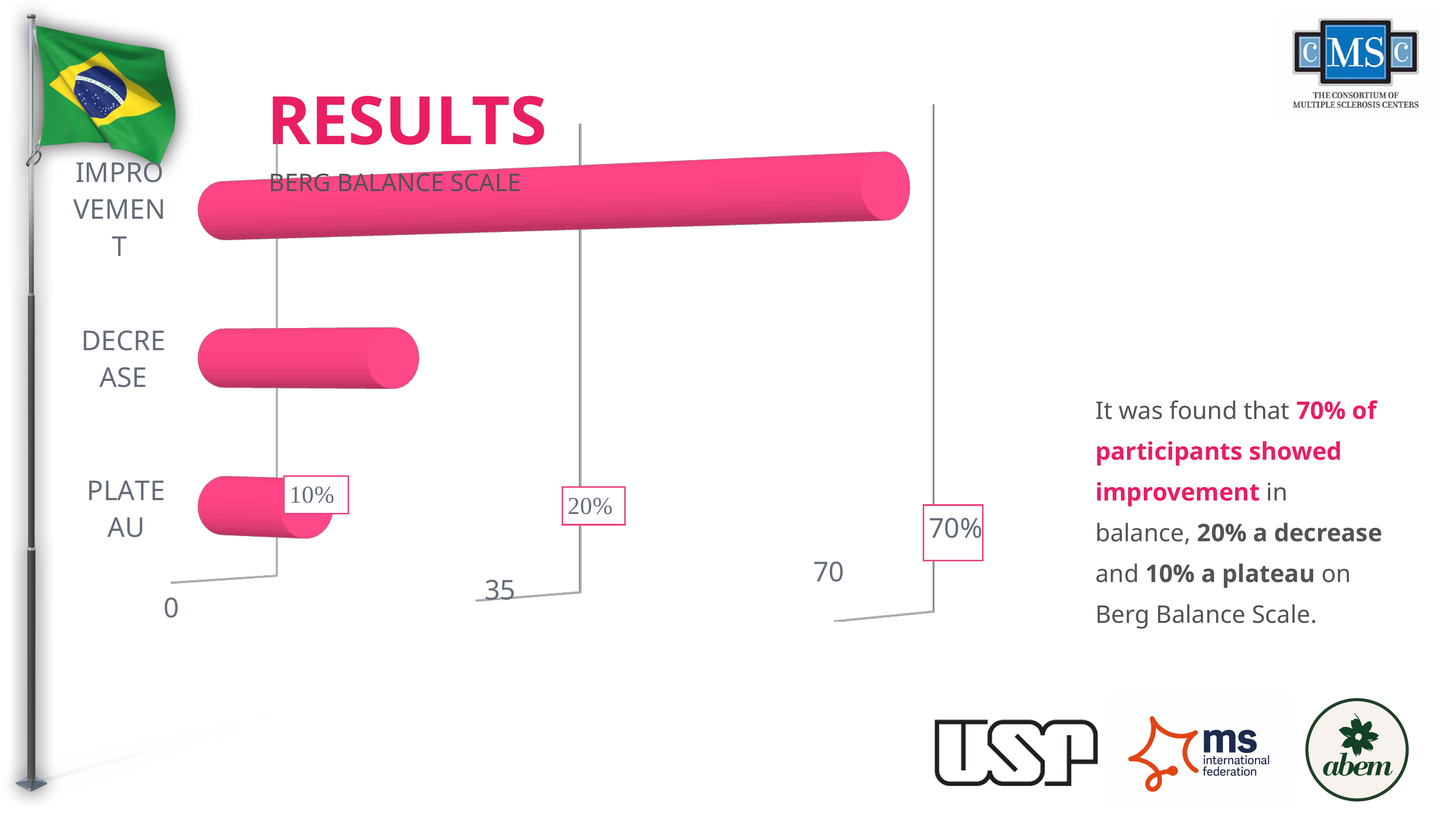
What is the value for DECREASE? 20% What is the title of the chart? BERG BALANCE SCALE What kind of chart is shown on the slide? bar chart Which category has the highest value? IMPROVEMENT What is the value for PLATEAU? 10% What is the difference between the values for IMPROVEMENT and DECREASE? 50% How many categories does the chart show? 3 Which category has the lowest value? PLATEAU Which is larger, the value for DECREASE or the value for PLATEAU? DECREASE Is the value for IMPROVEMENT greater or less than 35? greater What is the difference between the values for DECREASE and PLATEAU? 10% What is the value for IMPROVEMENT? 70%